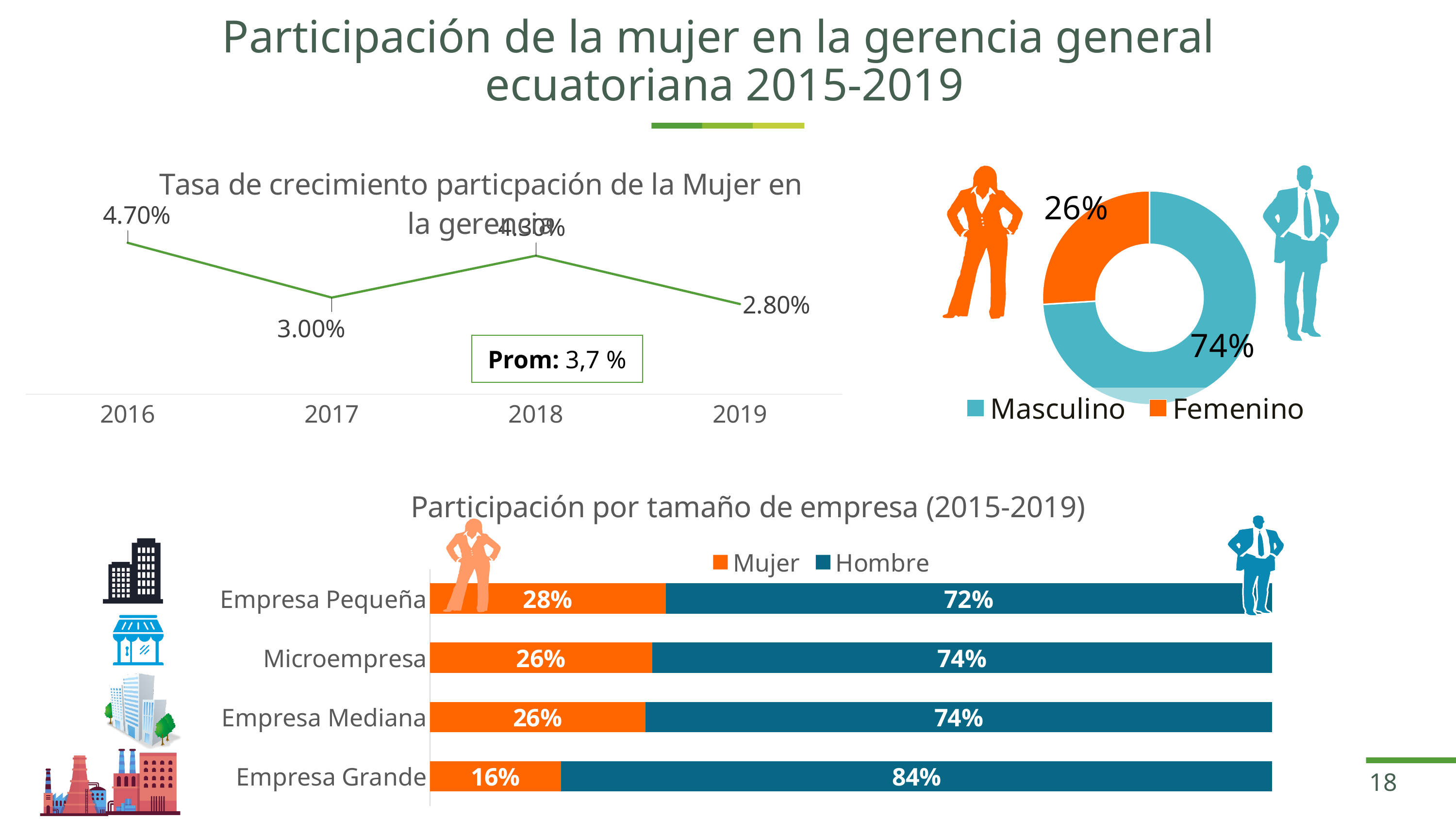
In the donut chart at the top right, what share is Femenino? 26% In the chart 'Participación por tamaño de empresa (2015-2019)', what is the difference between the Hombre and Mujer values for Empresa Grande? 68% In the line chart 'Tasa de crecimiento particpación de la Mujer en la gerencia', what is the value for 2019? 2.80% In the line chart 'Tasa de crecimiento particpación de la Mujer en la gerencia', which year has the lowest value? 2019 In the line chart 'Tasa de crecimiento particpación de la Mujer en la gerencia', how many years are plotted? 4 In the donut chart at the top right, what share is Masculino? 74% In the line chart 'Tasa de crecimiento particpación de la Mujer en la gerencia', which year has the highest value? 2016 In the line chart 'Tasa de crecimiento particpación de la Mujer en la gerencia', what is the value for 2016? 4.70% In the chart 'Participación por tamaño de empresa (2015-2019)', which company size has the highest Mujer share? Empresa Pequeña What kind of chart is 'Participación por tamaño de empresa (2015-2019)'? Stacked bar chart In the line chart 'Tasa de crecimiento particpación de la Mujer en la gerencia', what is the difference between the 2016 and 2017 values? 1.70% In the chart 'Participación por tamaño de empresa (2015-2019)', what is the Mujer value for Empresa Grande? 16%